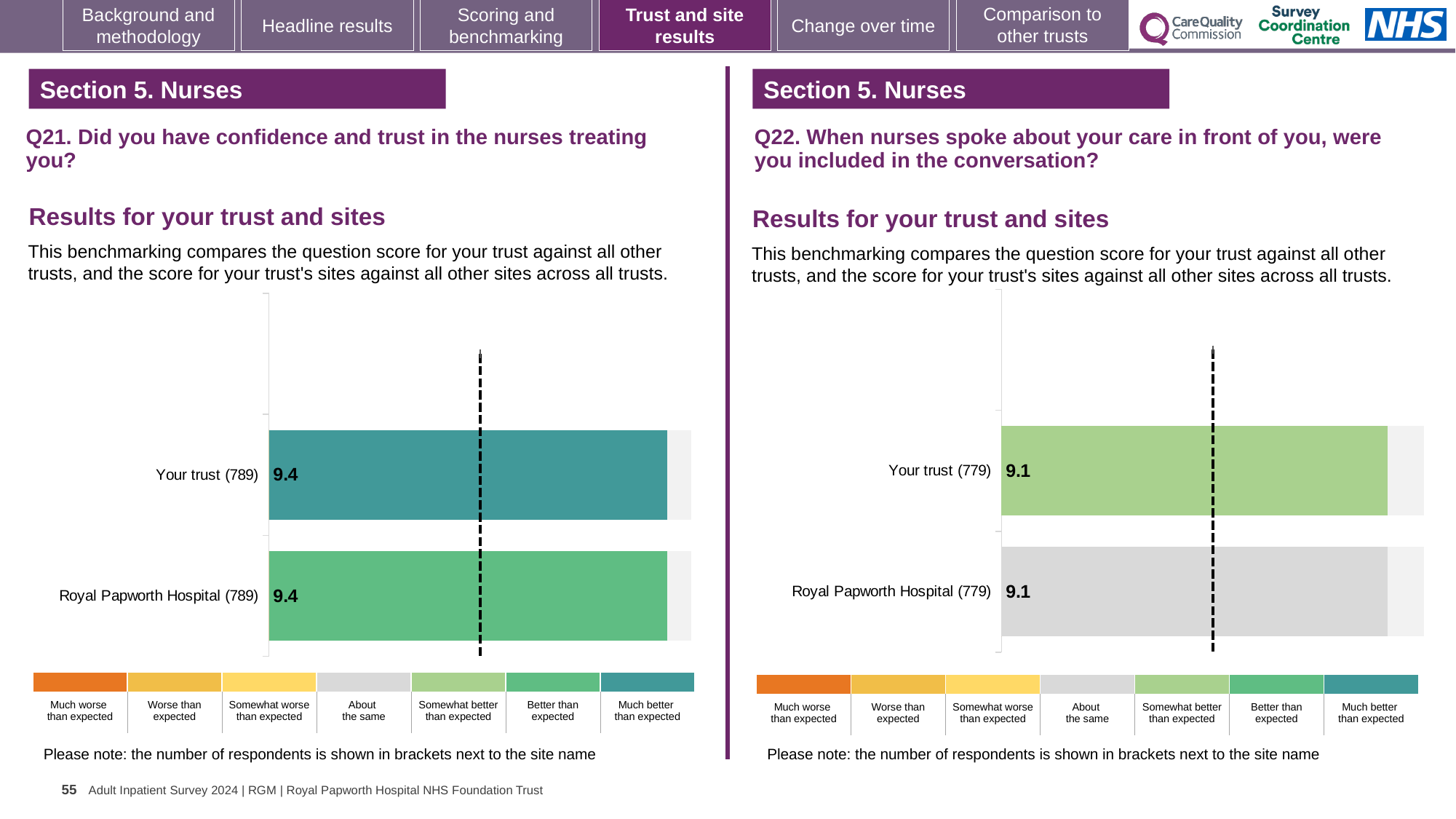
How many bars are plotted in the Q22 chart on the right? 2 In the Q22 chart on the right, which benchmark category does the colour of the Royal Papworth Hospital bar correspond to according to the legend? About the same What kind of chart is used for the Q21 results on the left? Bar chart In the Q21 chart on the left, which benchmark category does the colour of the Your trust bar correspond to according to the legend? Much better than expected In the Q22 chart on the right, what is the score for Your trust (779)? 9.1 In the Q22 chart on the right, what is the difference between the score for Your trust and the score for Royal Papworth Hospital? 0.0 In the Q21 chart on the left, what is the difference between the score for Your trust and the score for Royal Papworth Hospital? 0.0 How many bars are plotted in the Q21 chart on the left? 2 How many respondents are shown in brackets for Your trust in the Q22 chart on the right? 779 In the Q21 chart on the left, what is the score for Your trust (789)? 9.4 In the Q21 chart on the left, what is the score for Royal Papworth Hospital (789)? 9.4 In the Q22 chart on the right, what is the score for Royal Papworth Hospital (779)? 9.1